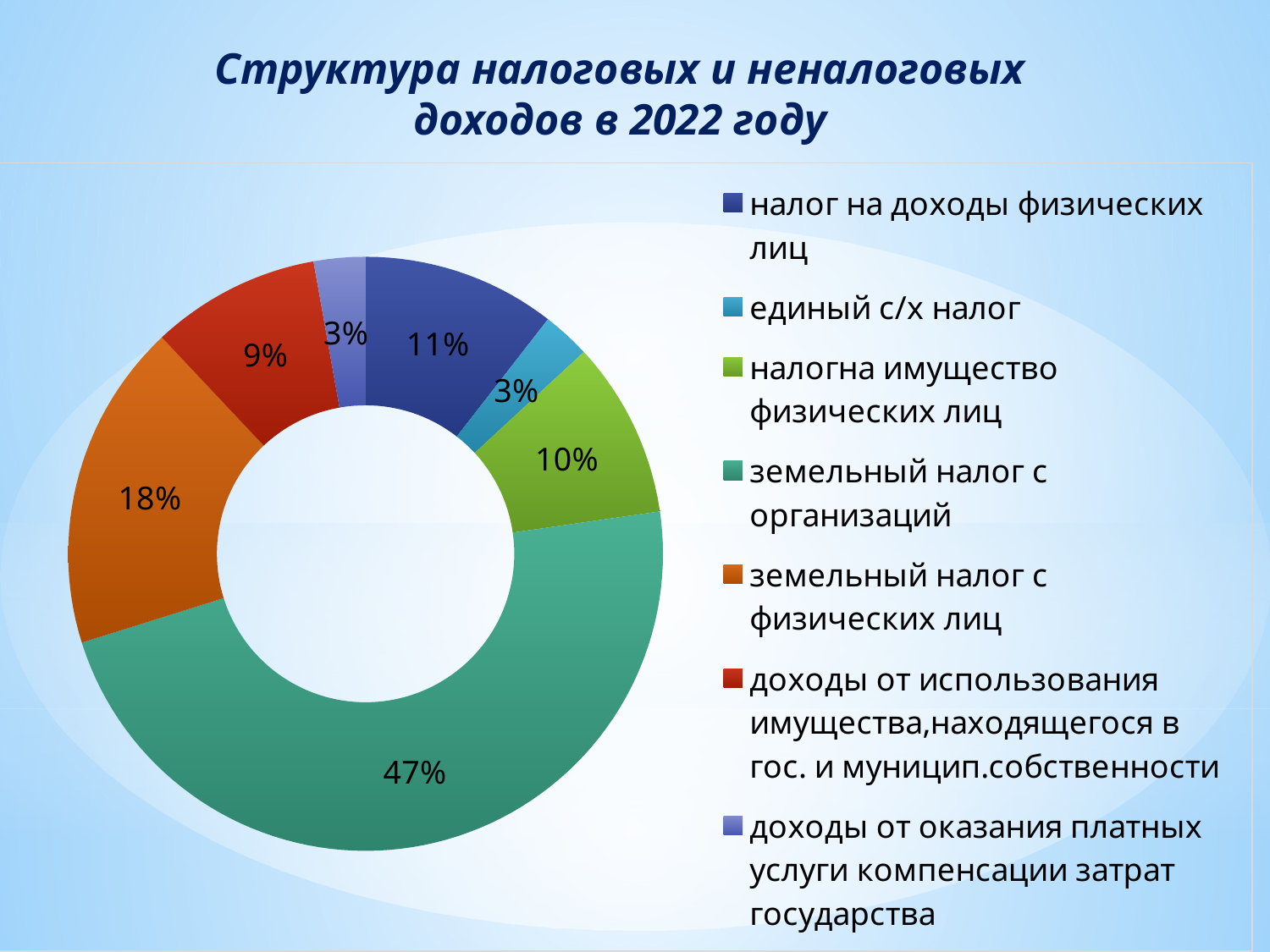
What kind of chart is shown on the slide? pie chart (doughnut) What percentage is shown for земельный налог с физических лиц? 18% What is the value for единый с/х налог? 3% How many categories does the chart show? 7 What share of revenues does земельный налог с организаций account for? 47% What share is shown for доходы от использования имущества, находящегося в гос. и муницип. собственности? 9% Which is larger: налог на доходы физических лиц or налог на имущество физических лиц? налог на доходы физических лиц What is the value shown for налог на доходы физических лиц? 11% Which category has the largest share of the chart? земельный налог с организаций What colour represents земельный налог с организаций in the chart? teal green What is the difference in percentage points between земельный налог с организаций and земельный налог с физических лиц? 29 What is the title of the slide? Структура налоговых и неналоговых доходов в 2022 году